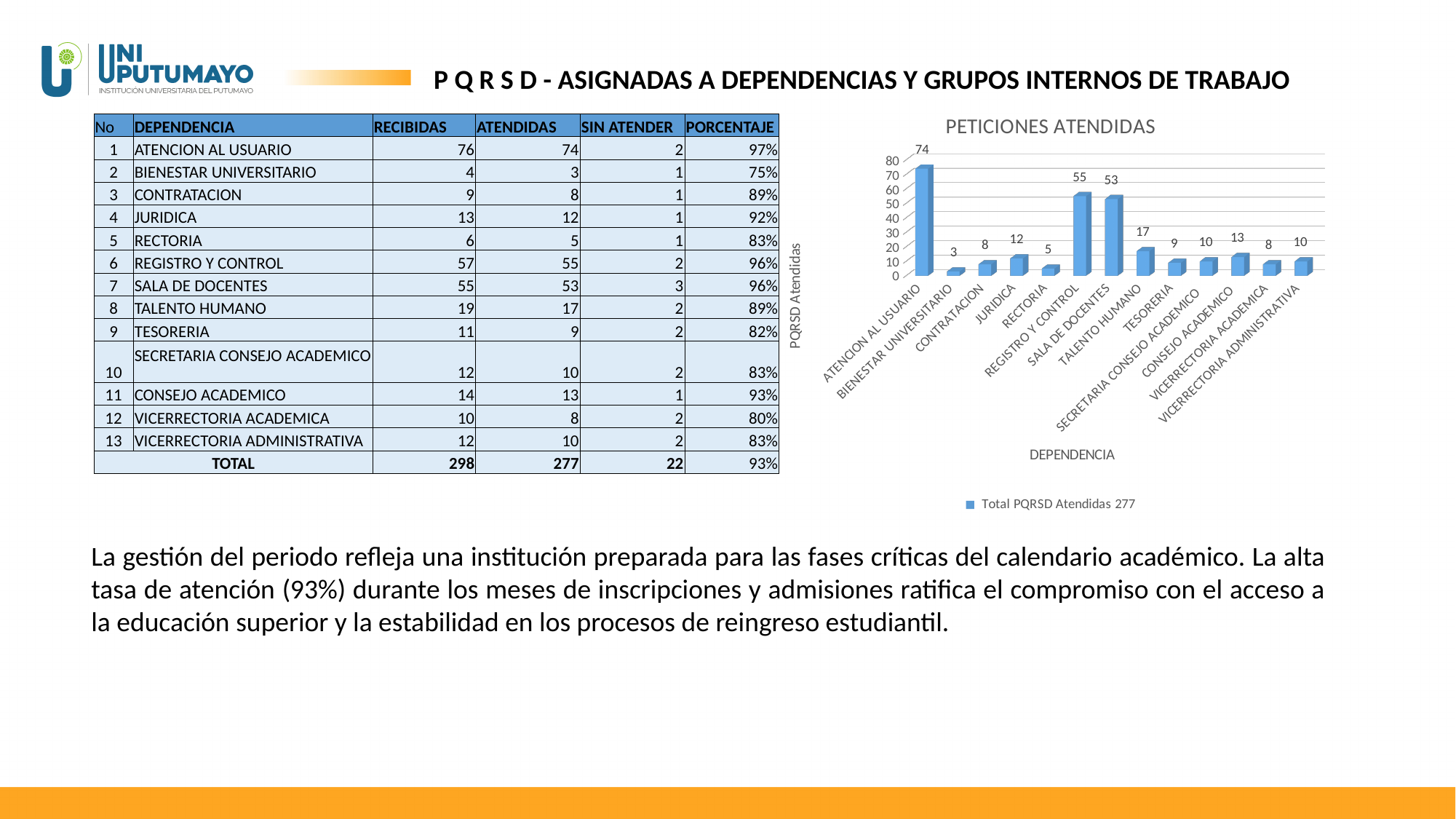
What kind of chart is PETICIONES ATENDIDAS? Bar chart How many series does the legend of the PETICIONES ATENDIDAS chart list? 1 Which dependencia has the lowest value in the PETICIONES ATENDIDAS chart? BIENESTAR UNIVERSITARIO Which dependencia has the highest value in the PETICIONES ATENDIDAS chart? ATENCION AL USUARIO Which is larger in the PETICIONES ATENDIDAS chart, JURIDICA or CONSEJO ACADEMICO? CONSEJO ACADEMICO What is the value for TALENTO HUMANO in the PETICIONES ATENDIDAS chart? 17 What is the value for ATENCION AL USUARIO in the PETICIONES ATENDIDAS chart? 74 Is the value for REGISTRO Y CONTROL in the PETICIONES ATENDIDAS chart greater or less than 50? greater What is the value for SALA DE DOCENTES in the PETICIONES ATENDIDAS chart? 53 What is the difference between the values for REGISTRO Y CONTROL and SALA DE DOCENTES in the PETICIONES ATENDIDAS chart? 2 What is the legend entry of the PETICIONES ATENDIDAS chart? Total PQRSD Atendidas 277 How many dependencias are shown in the PETICIONES ATENDIDAS chart? 13